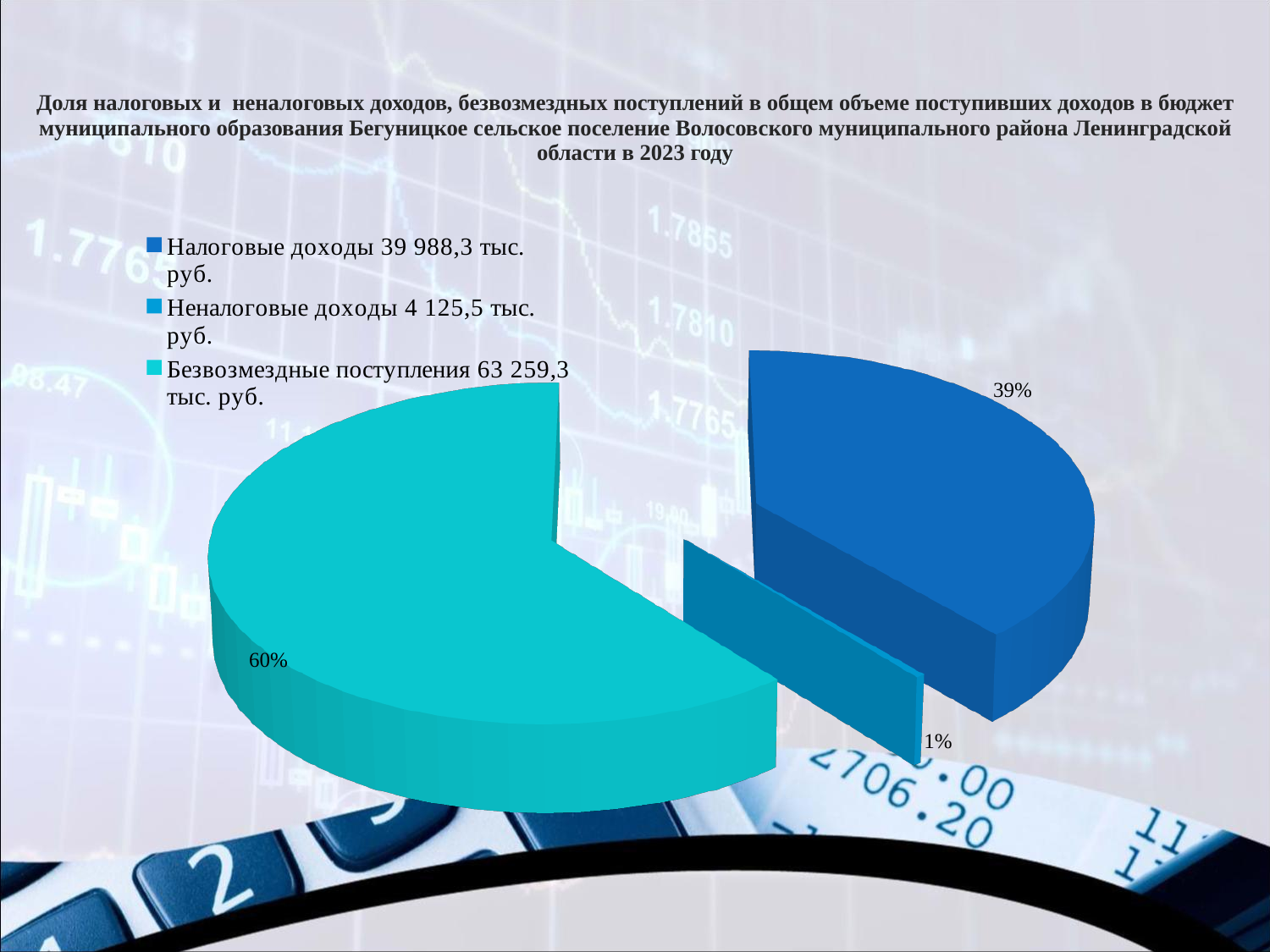
Какая сумма безвозмездных поступлений указана в легенде? 63 259,3 тыс. руб. Что больше: доля налоговых доходов или доля безвозмездных поступлений? Безвозмездные поступления Какая доля приходится на неналоговые доходы согласно подписи на диаграмме? 1% Какой тип диаграммы показан на слайде? Круговая диаграмма Какая доля приходится на налоговые доходы согласно подписи на диаграмме? 39% Сколько категорий (секторов) показано на круговой диаграмме? 3 На сколько процентных пунктов доля безвозмездных поступлений больше доли налоговых доходов? 21% Какая категория имеет наименьшую долю на диаграмме? Неналоговые доходы Какая доля приходится на безвозмездные поступления согласно подписи на диаграмме? 60% Какая сумма неналоговых доходов указана в легенде? 4 125,5 тыс. руб. Какая сумма налоговых доходов указана в легенде? 39 988,3 тыс. руб. Какая категория имеет наибольшую долю на диаграмме? Безвозмездные поступления